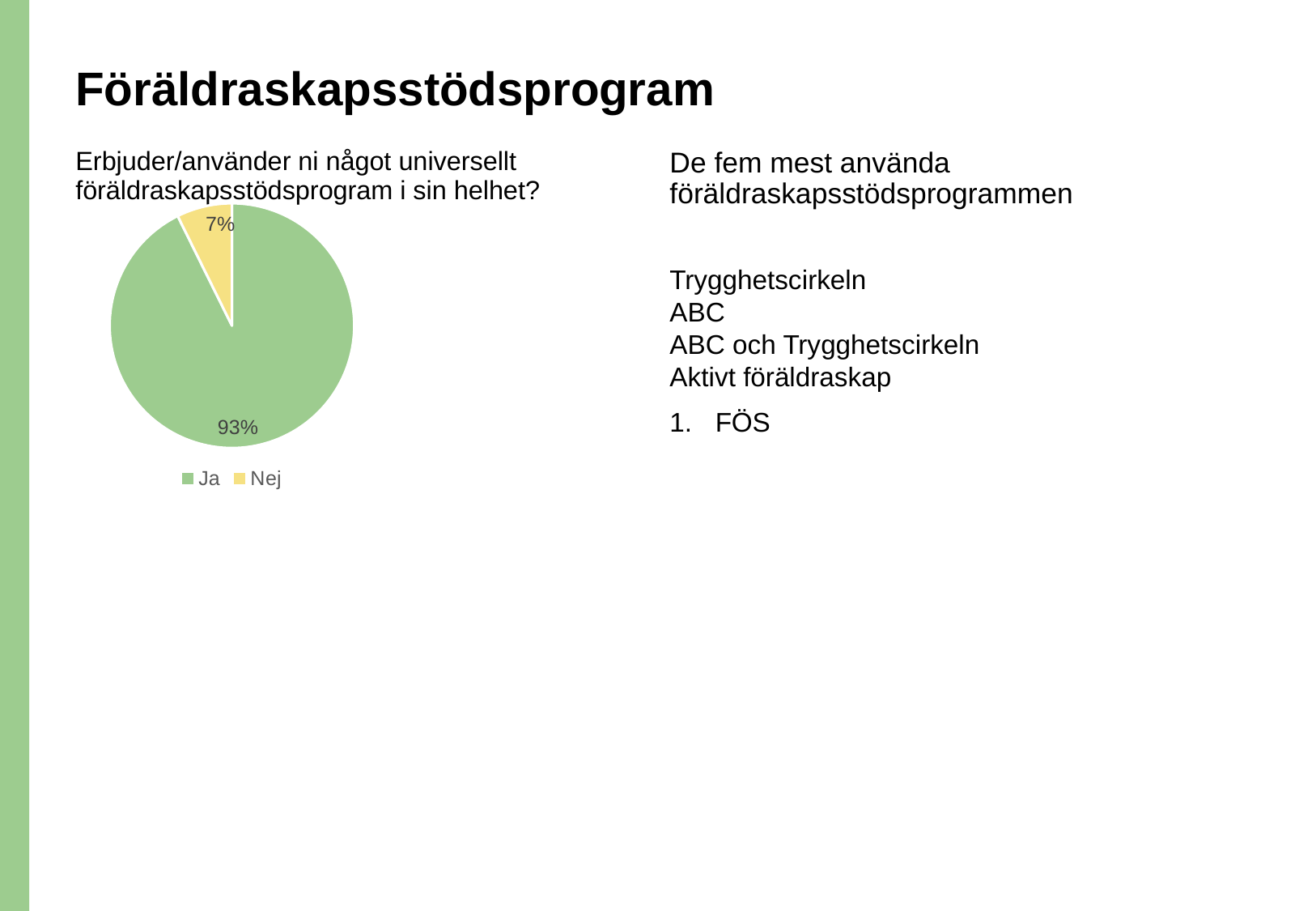
How many entries does the legend of the pie chart list? 2 What kind of chart is shown on the slide? pie chart How many slices does the pie chart have? 2 Which slice of the pie chart is the smallest? Nej What colour is the "Nej" slice in the pie chart? yellow What question does the pie chart answer, according to the text above it? Erbjuder/använder ni något universellt föräldraskapsstödsprogram i sin helhet? What is the difference in percentage points between the "Ja" and "Nej" slices? 86 Which is larger, the "Ja" slice or the "Nej" slice? Ja Which slice of the pie chart is the largest? Ja What share of the pie does "Nej" represent? 7% What share of the pie does "Ja" represent? 93%